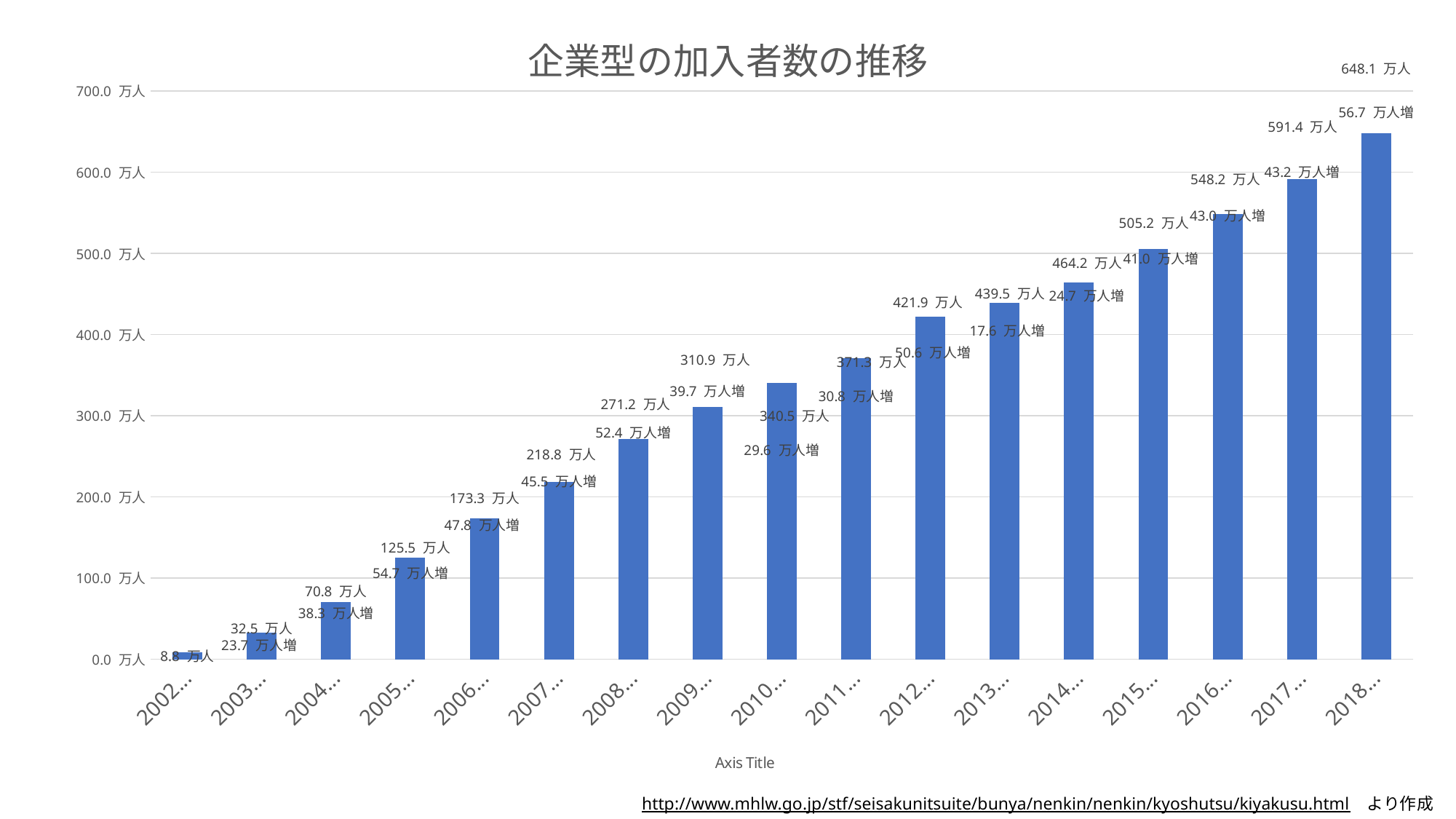
Which year has the lowest value in the chart? 2002 What is the value labelled for the 2002 bar? 8.8 万人 What is the difference between the 2018 value (648.1 万人) and the 2017 value (591.4 万人)? 56.7 万人 What type of chart is shown on the slide? bar chart What is the value labelled for the 2018 bar? 648.1 万人 Which year has the highest value in the chart? 2018 How many bars (years) are plotted in the chart? 17 Is the value for 2015 greater or less than 500.0 万人? greater What is the value labelled for the 2010 bar? 340.5 万人 Which is larger, the value for 2009 or the value for 2011? 2011 What is the title of the chart? 企業型の加入者数の推移 Do the values rise or fall from 2002 to 2018 along the x axis? rise